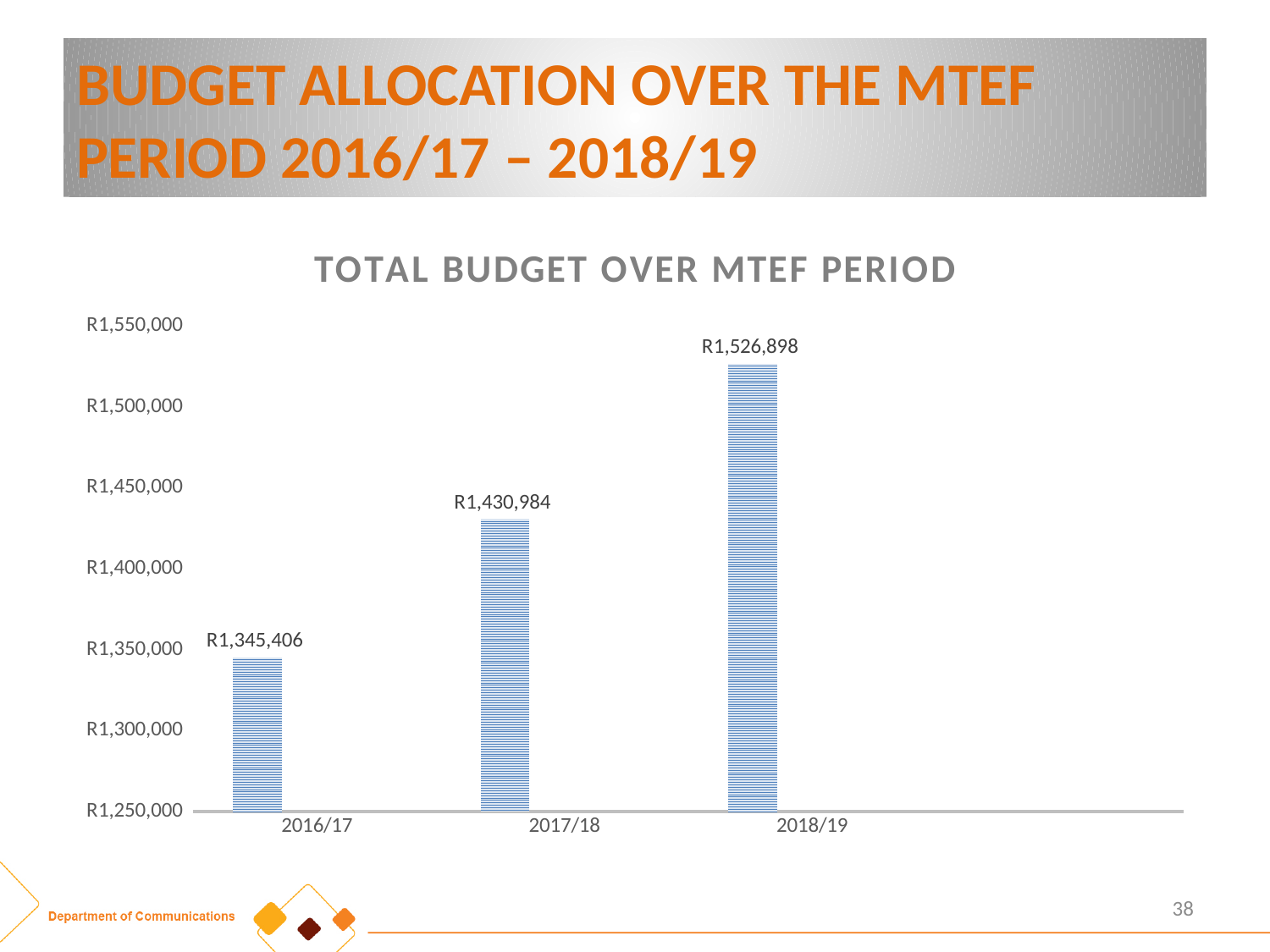
What is the total budget for 2018/19? R1,526,898 Which is larger, the budget for 2017/18 or the budget for 2018/19? 2018/19 Is the value for 2017/18 greater or less than R1,400,000? greater Do the budget values rise or fall from 2016/17 to 2018/19? rise What kind of chart is shown on the slide? bar chart How many years are shown on the x axis? 3 Which year has the lowest total budget? 2016/17 What is the total budget for 2016/17? R1,345,406 What is the total budget for 2017/18? R1,430,984 What is the difference between the 2018/19 budget and the 2016/17 budget? R181,492 Which year has the highest total budget? 2018/19 What is the difference between the 2017/18 budget and the 2016/17 budget? R85,578